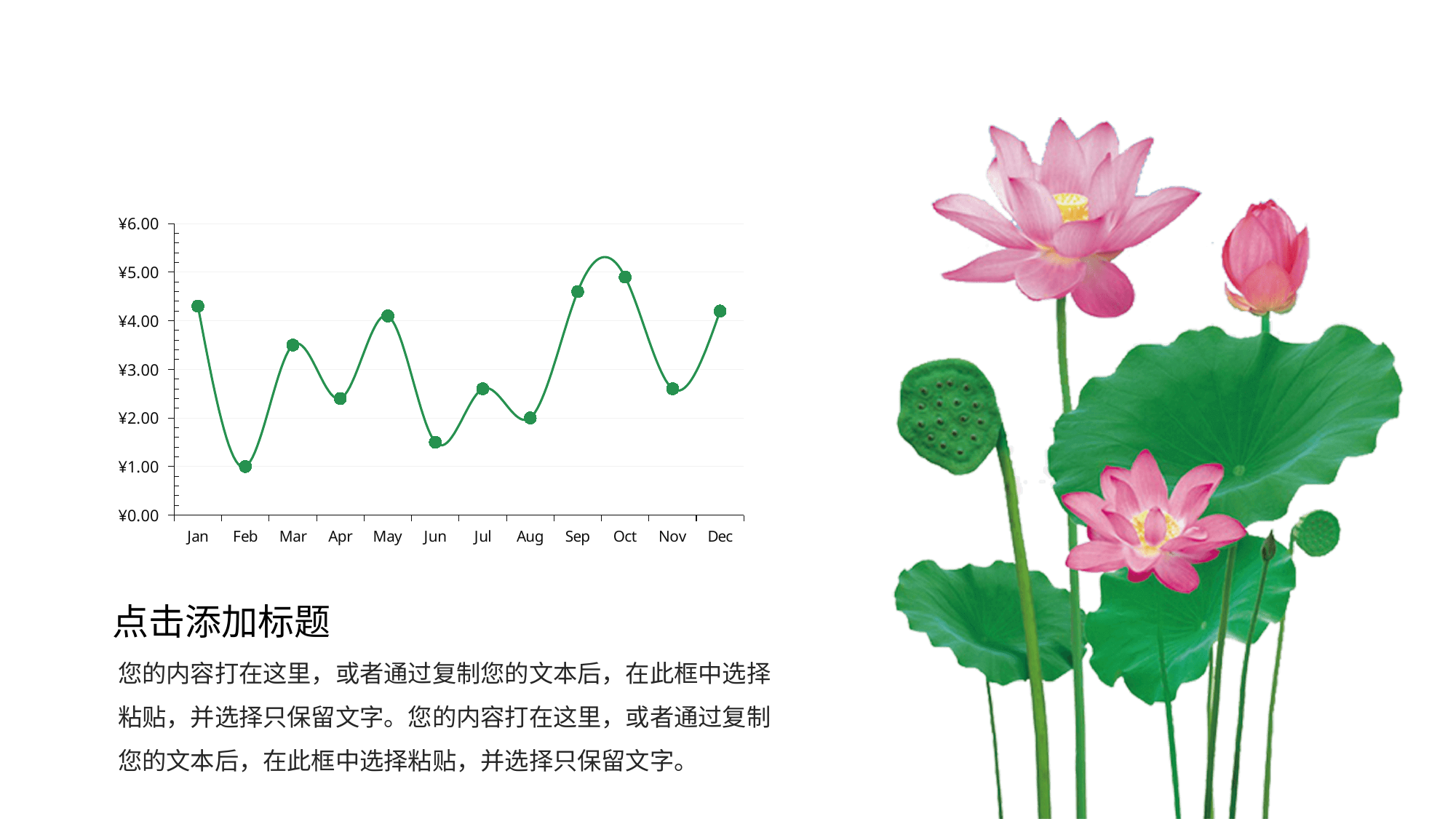
Which is larger, the value for Nov or the value for Dec? Dec Is the value for Sep greater or less than ¥4.00? greater Which is larger, the value for Mar or the value for Apr? Mar Which month has the highest value in the chart? Oct What colour is the line in the chart? green Does the value rise or fall from Jan to Feb? fall Is the value for Aug greater or less than ¥3.00? less Is the value for Jan greater or less than ¥4.00? greater What kind of chart is shown on the slide? line chart How many months are plotted on the x axis of the chart? 12 Which month has the lowest value in the chart? Feb